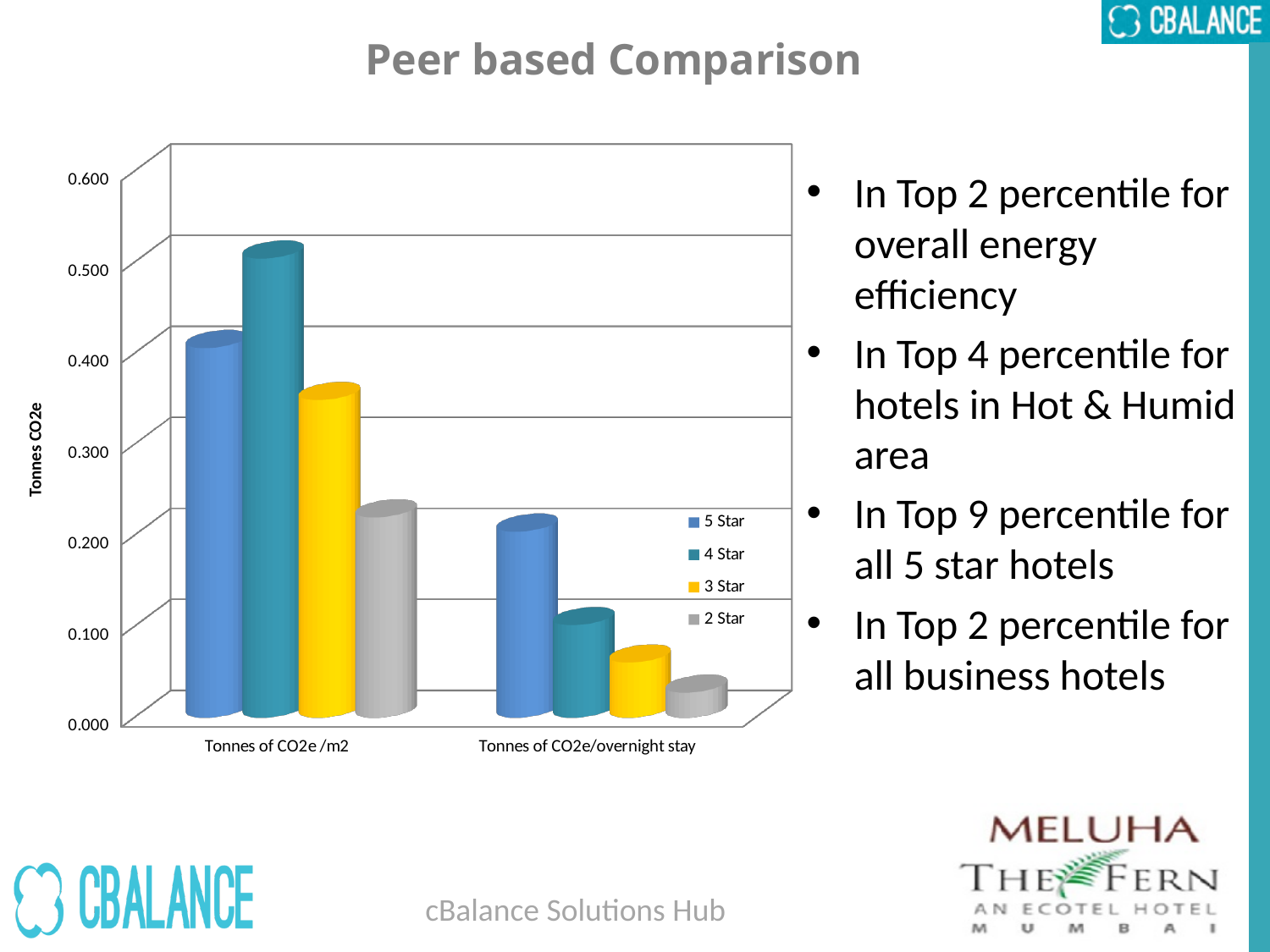
How many categories are shown on the x axis of the chart? 2 Is the 4 Star value for Tonnes of CO2e/overnight stay greater or less than 0.200? less Is the 2 Star value for Tonnes of CO2e /m2 greater or less than 0.300? less Which series has the lowest value for Tonnes of CO2e/overnight stay? 2 Star Which series has the highest value for Tonnes of CO2e /m2? 4 Star Is the 4 Star value for Tonnes of CO2e /m2 greater or less than 0.400? greater Which series has the lowest value for Tonnes of CO2e /m2? 2 Star For Tonnes of CO2e /m2, which is larger: the 5 Star value or the 3 Star value? 5 Star What kind of chart is shown on the slide? Bar chart Which series has the highest value for Tonnes of CO2e/overnight stay? 5 Star What is the title of the vertical axis of the chart? Tonnes CO2e How many series does the chart legend list? 4